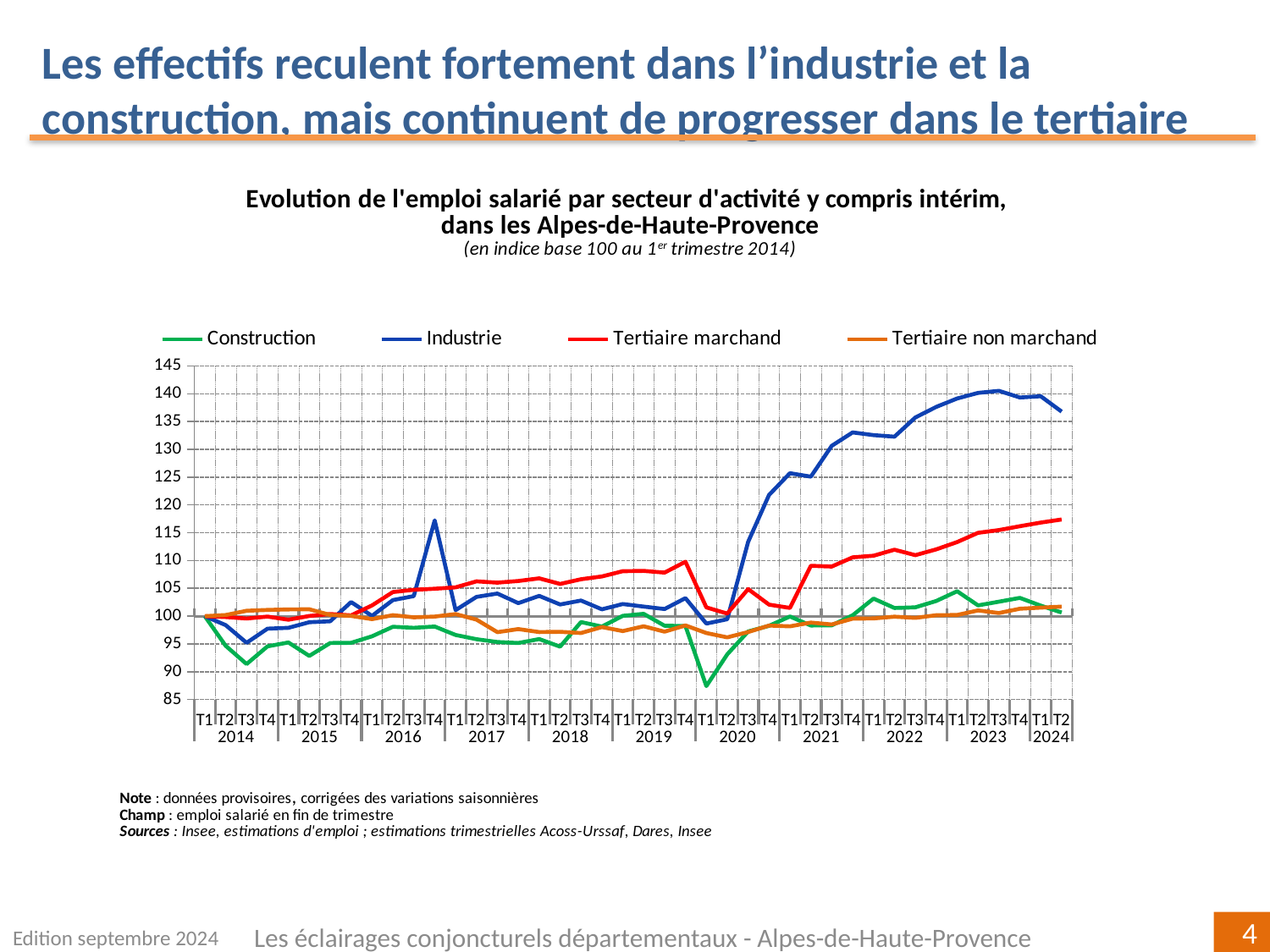
At T2 2024, which is larger: the value for Industrie or the value for Construction? Industrie What kind of chart is shown on the slide? line chart Which series has the lowest value at T1 2020? Construction How many quarterly points are plotted along the x axis, from T1 2014 to T2 2024? 42 Is the value for Industrie at T2 2024 greater or less than 130? greater Which colour is used for the Tertiaire marchand series? red Is the value for Tertiaire marchand at T2 2024 greater or less than 115? greater How many series does the legend list? 4 Is the value for Construction at T1 2020 greater or less than 90? less Does the Industrie series rise or fall between T1 2020 and T1 2023? rise Which series has the highest value at T2 2024? Industrie